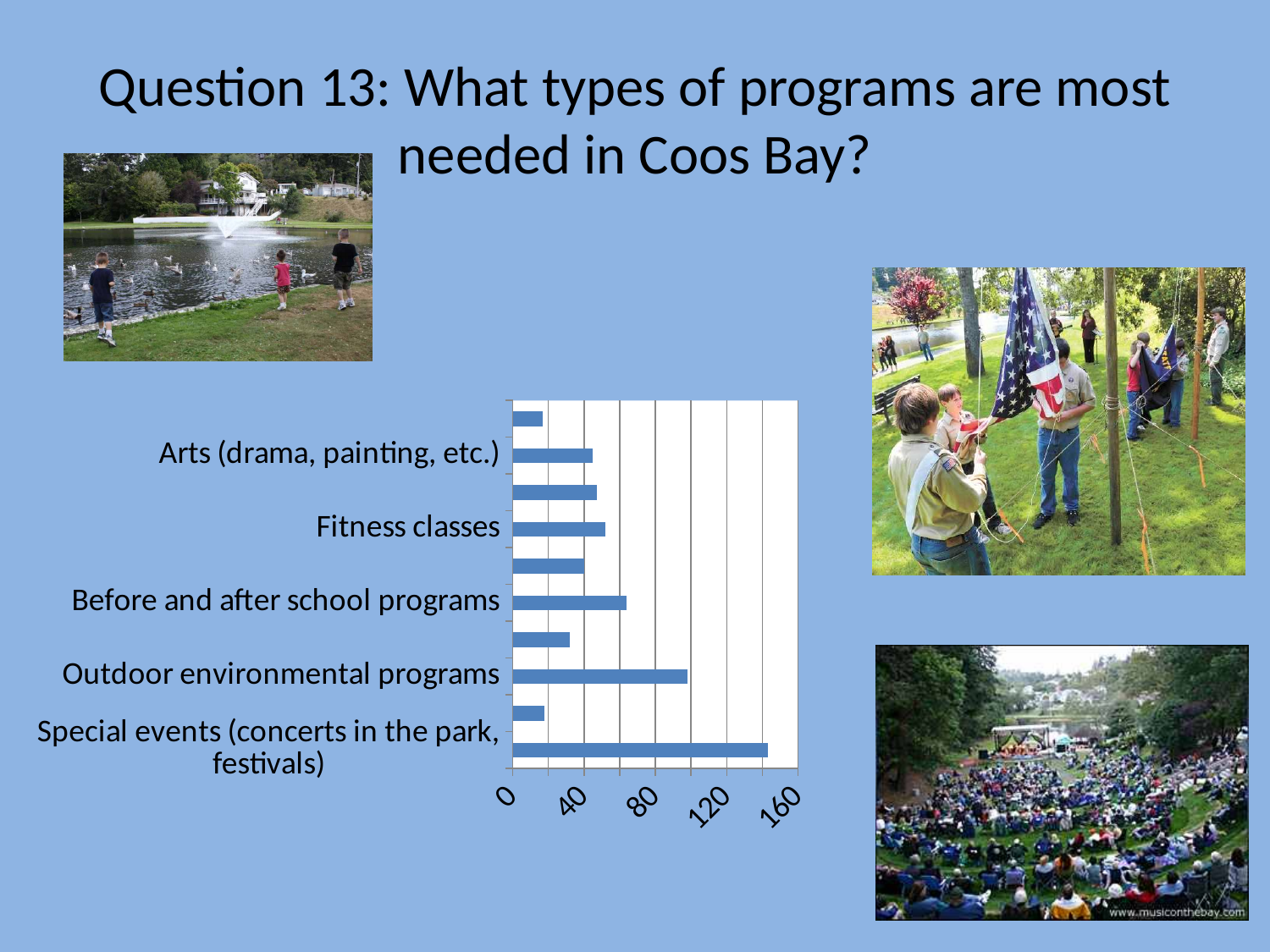
What is the highest tick value shown on the chart's value axis? 160 Is the value for Before and after school programs greater or less than 40? greater Is the value for Outdoor environmental programs greater or less than 80? greater Is the value for Before and after school programs greater or less than 80? less What kind of chart is shown on the slide? bar chart Which has a larger value, Special events (concerts in the park, festivals) or Outdoor environmental programs? Special events (concerts in the park, festivals) How many bars does the chart contain? 10 Which labeled category has the highest value in the chart? Special events (concerts in the park, festivals) Which has a larger value, Outdoor environmental programs or Before and after school programs? Outdoor environmental programs